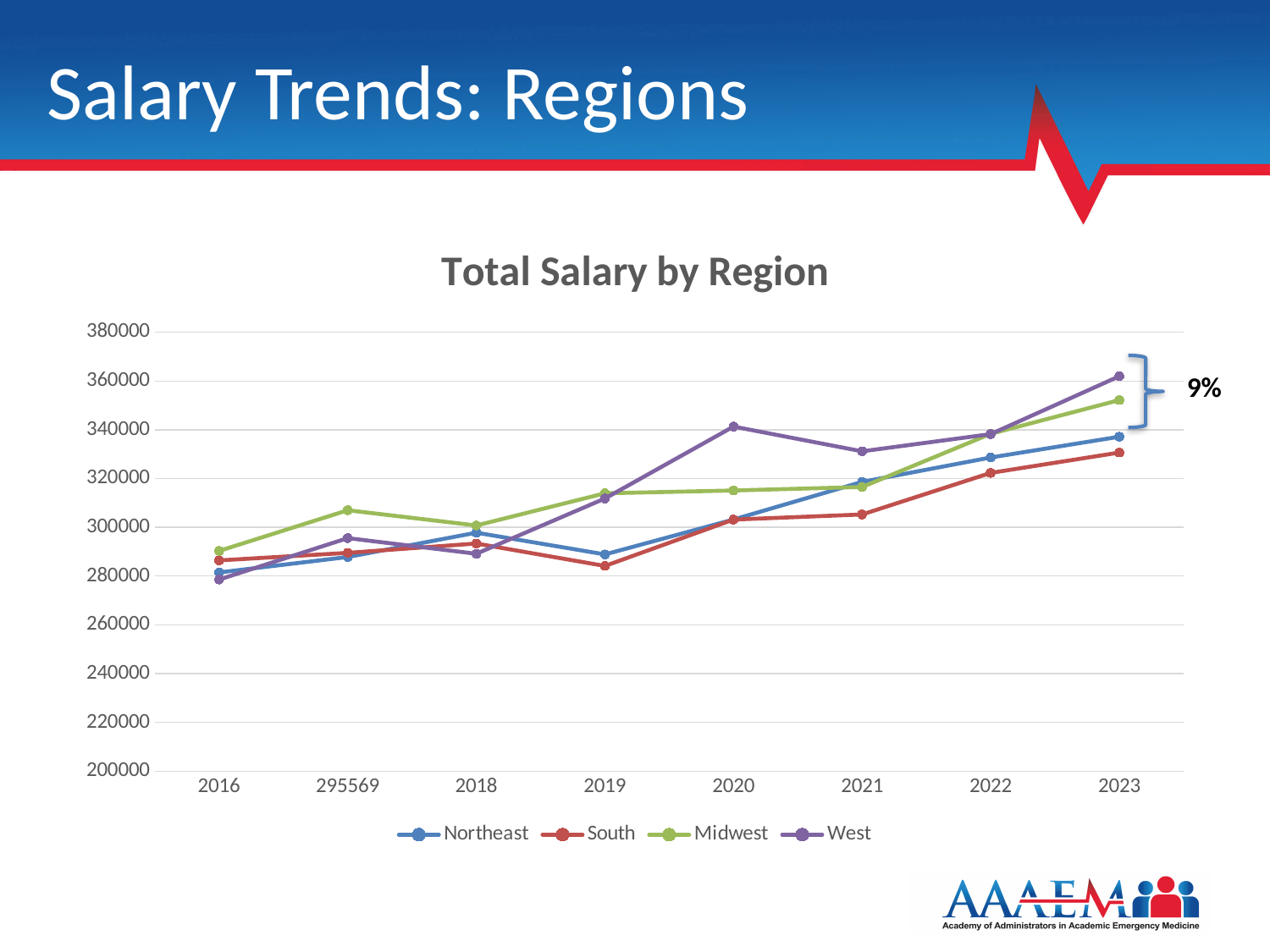
What is the title of the chart? Total Salary by Region Is the value for South in 2019 greater or less than 300000? less How many points along the x axis does each line have? 8 Which region has the highest value in 2023? West Is the value for West in 2020 greater or less than 320000? greater Does the Northeast line rise or fall from 2019 to 2023? rise In 2021, which is larger, the value for West or the value for South? West Is the value for Midwest in 2023 greater or less than 340000? greater How many series does the legend list? 4 Which region has the highest value in 2020? West What kind of chart is shown on the slide? line chart Which region has the lowest value in 2023? South